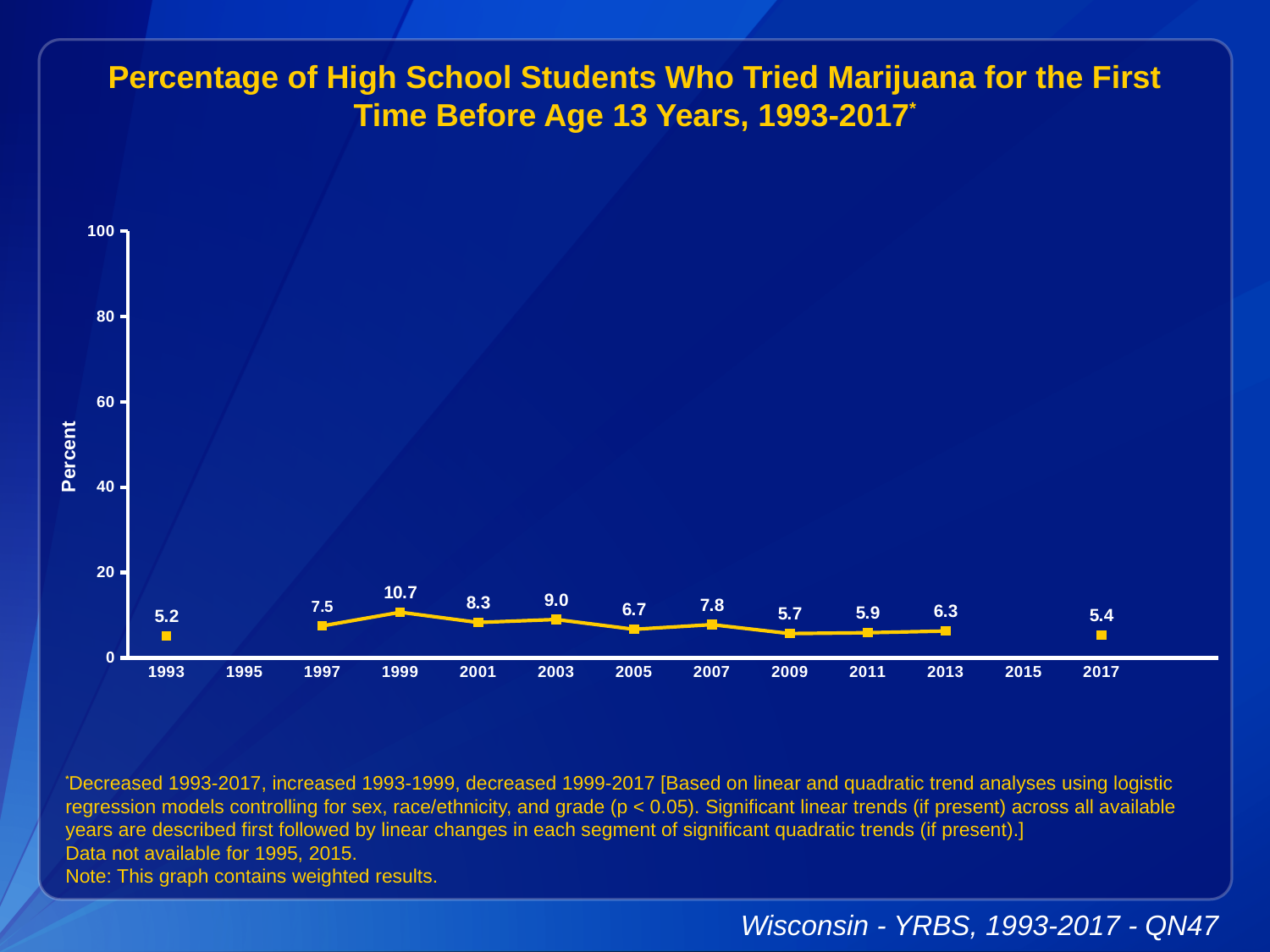
What is the difference between the 1999 value and the 1993 value? 5.5 Which year has the lowest percentage? 1993 What value is shown for 2017? 5.4 What kind of chart is shown on the slide? line chart Which year has the highest percentage? 1999 How many years have a plotted data point on the chart? 11 Do the values generally rise or fall from 1999 to 2017? fall What value is shown for 2009? 5.7 Is the value for 1999 greater or less than 20? less What is the difference between the 2003 value and the 2005 value? 2.3 Which year has the larger value, 2001 or 2003? 2003 What was the percentage of high school students who tried marijuana before age 13 in 1999? 10.7